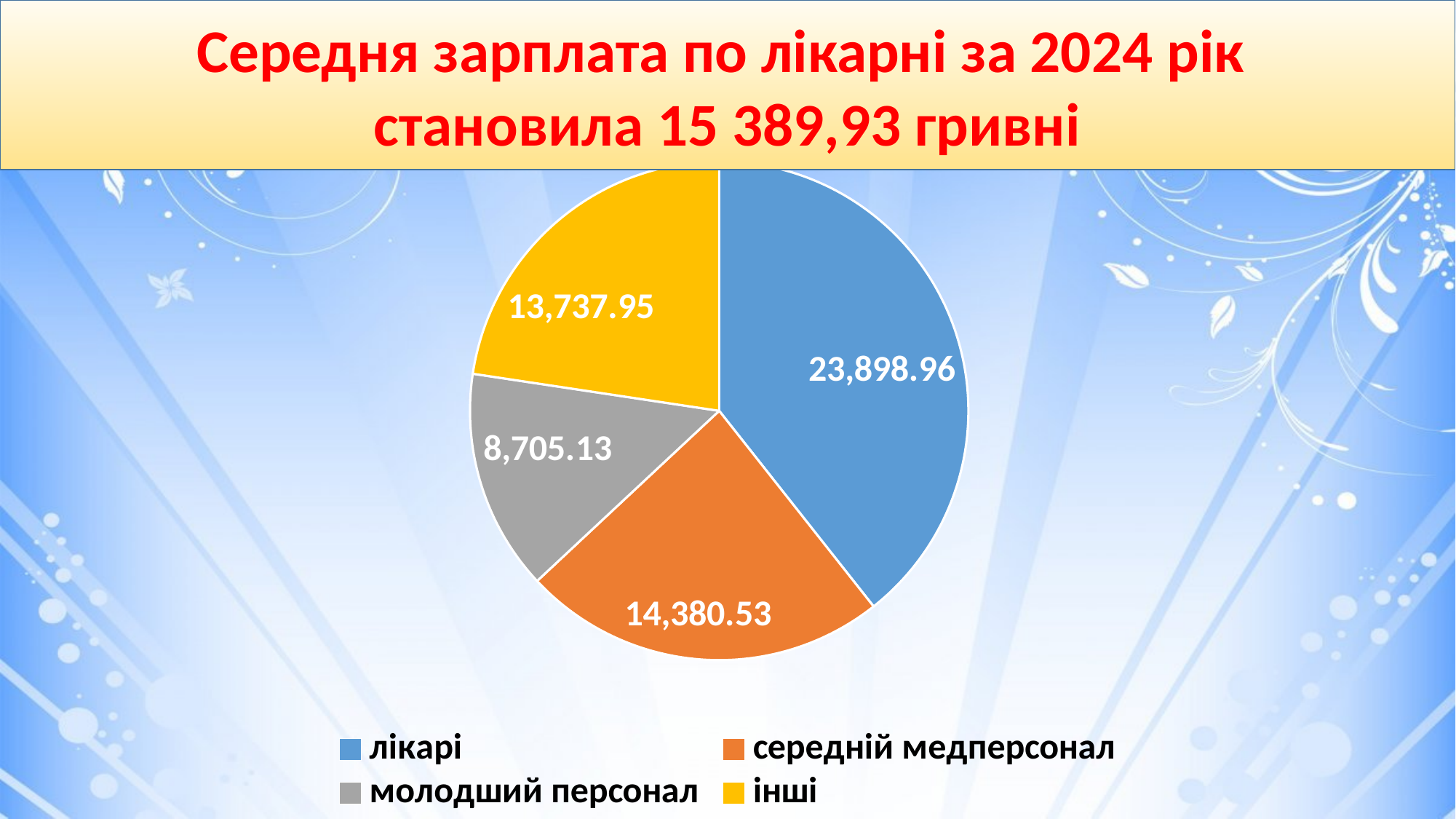
What is the value shown for інші? 13,737.95 What is the value shown for молодший персонал? 8,705.13 What is the difference between the values for інші and молодший персонал? 5,032.82 What is the value shown for середній медперсонал? 14,380.53 What is the difference between the values for лікарі and середній медперсонал? 9,518.43 Which category has the lowest value in the pie chart? молодший персонал What is the value shown for лікарі? 23,898.96 What type of chart is shown on the slide? pie chart How many categories does the pie chart have? 4 Which is larger, the value for середній медперсонал or the value for інші? середній медперсонал Which category has the highest value in the pie chart? лікарі What colour is the slice for інші? yellow